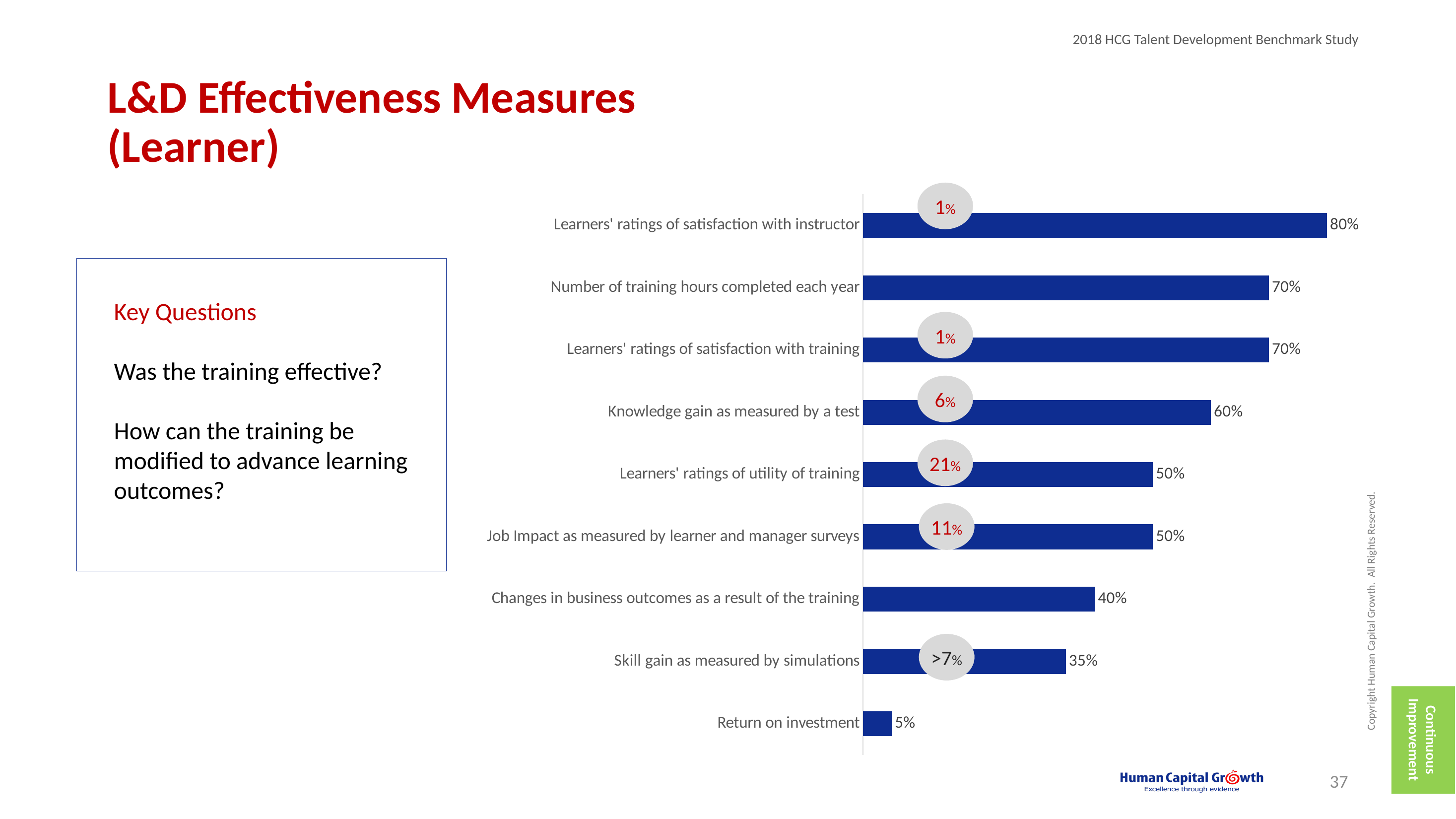
What is the value for Knowledge gain as measured by a test? 60% How many categories are shown in the chart? 9 What is the difference between Knowledge gain as measured by a test and Skill gain as measured by simulations? 25% What is the value for Learners' ratings of satisfaction with instructor? 80% What is the value for Changes in business outcomes as a result of the training? 40% Which is larger: Number of training hours completed each year or Learners' ratings of utility of training? Number of training hours completed each year Which category has the highest value? Learners' ratings of satisfaction with instructor What kind of chart is shown on the slide? Bar chart What number is shown in the grey circle next to the Learners' ratings of utility of training bar? 21% What is the difference between Learners' ratings of satisfaction with instructor and Return on investment? 75% Which category has the lowest value? Return on investment What is the value for Skill gain as measured by simulations? 35%